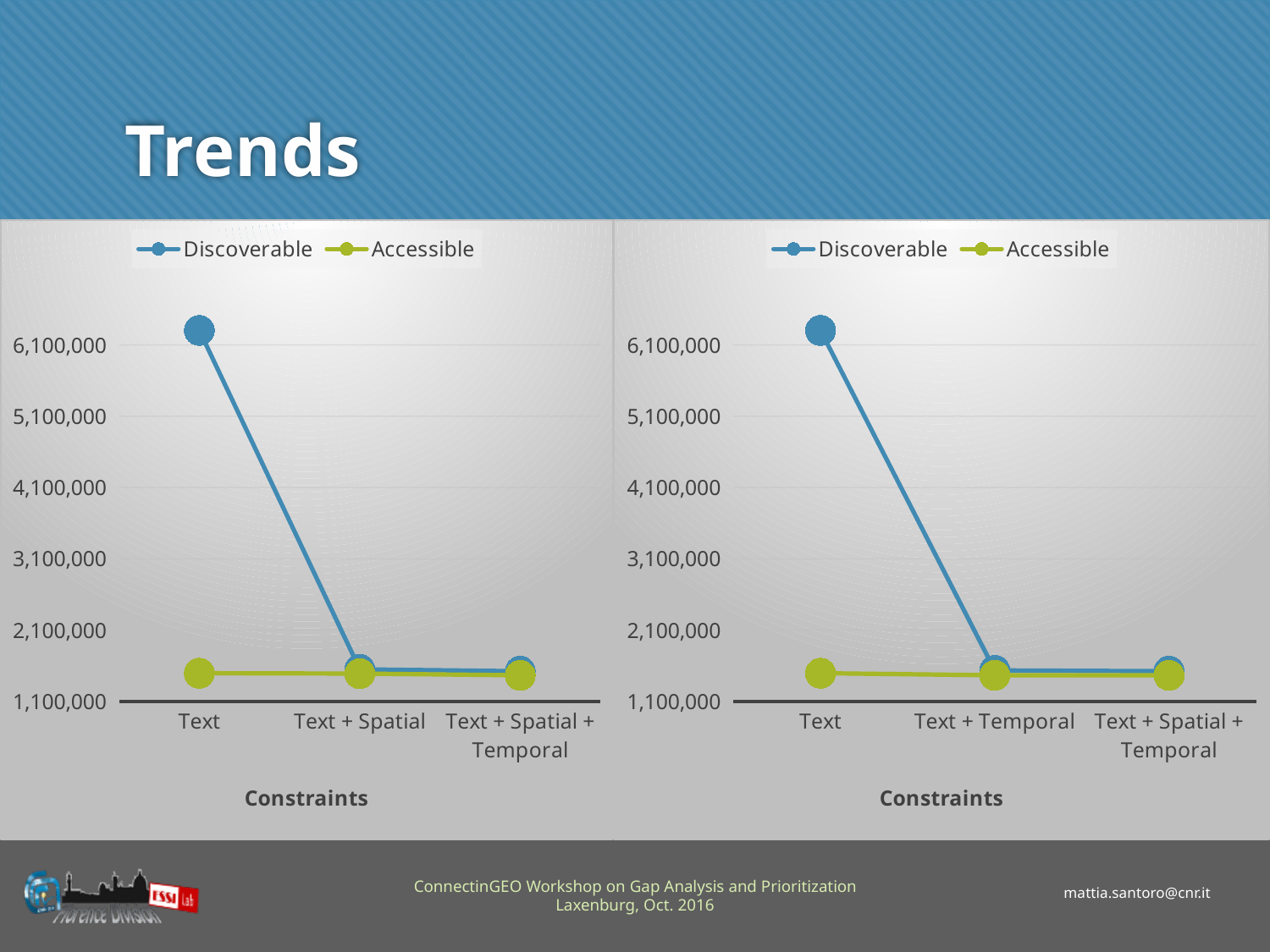
In the right chart, which category has the highest Discoverable value? Text In the left chart, which category has the highest Discoverable value? Text What is the x-axis title of the right chart? Constraints What kind of chart is the left chart? line chart How many categories are shown on the x axis of the left chart? 3 In the right chart, does the Discoverable series rise or fall from Text to Text + Temporal? fall In the left chart, which is larger for Text: Discoverable or Accessible? Discoverable In the left chart, is the Discoverable value for Text + Spatial greater or less than 3,100,000? less How many series does the legend of the right chart list? 2 In the right chart, is the Accessible value for Text greater or less than 2,100,000? less In the left chart, is the Discoverable value for Text greater or less than 5,100,000? greater What is the second category on the x axis of the right chart? Text + Temporal